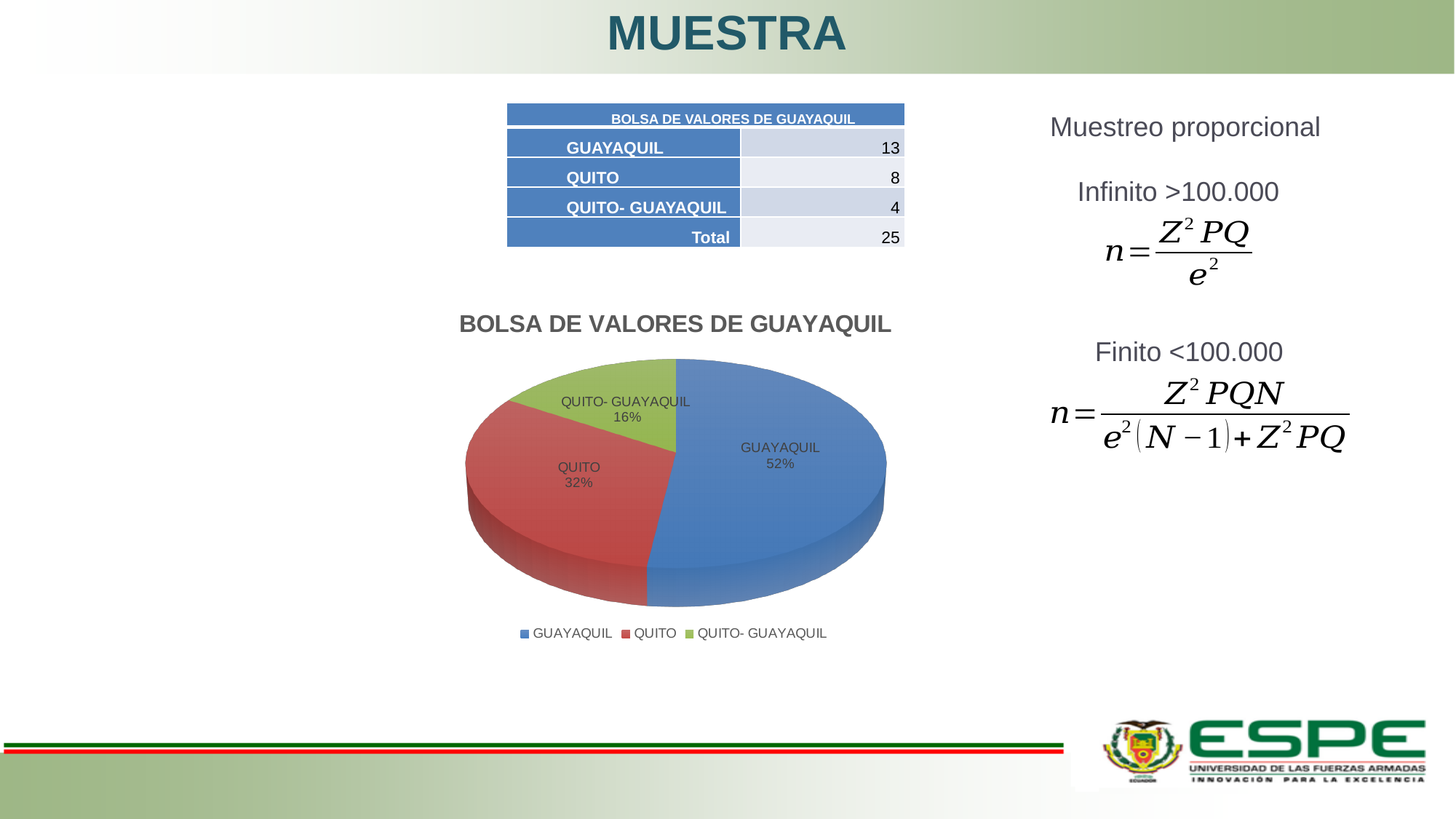
What is the difference in percentage points between the GUAYAQUIL and QUITO slices? 20% What is the title of the pie chart? BOLSA DE VALORES DE GUAYAQUIL Which slice of the pie chart is the largest? GUAYAQUIL How many slices does the pie chart have? 3 What share of the pie does QUITO- GUAYAQUIL represent? 16% What kind of chart is shown on the slide? Pie chart Which slice of the pie chart is the smallest? QUITO- GUAYAQUIL What share of the pie does QUITO represent? 32% Which slice is larger, QUITO or QUITO- GUAYAQUIL? QUITO What colour is the QUITO slice in the pie chart? Red How many entries does the legend of the pie chart list? 3 What share of the pie does GUAYAQUIL represent? 52%